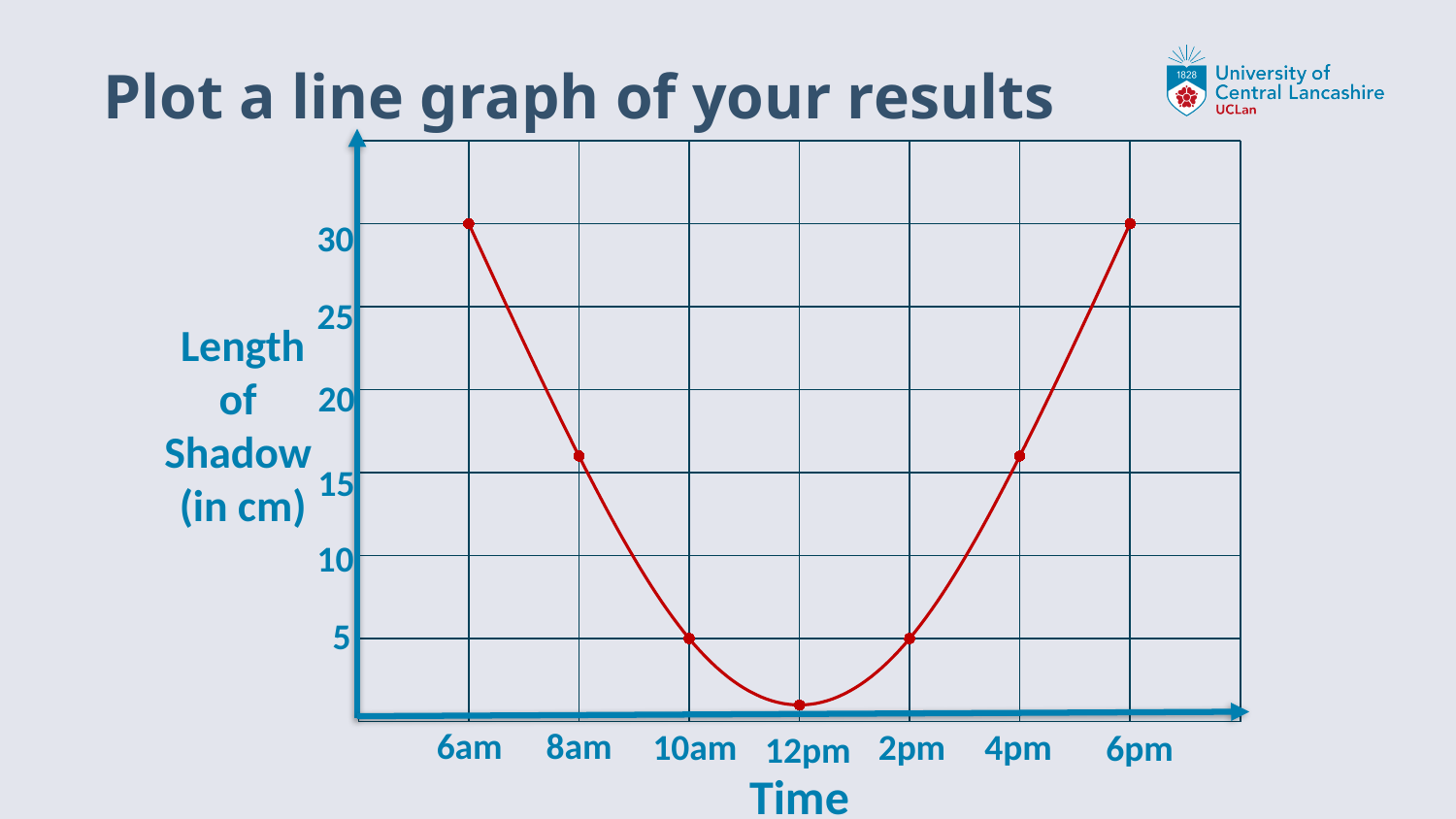
What is the length of the shadow at 2pm? 5 What is the length of the shadow at 6pm? 30 What is the difference between the shadow length at 6am and at 10am? 25 How many data points are plotted on the line graph? 7 Is the shadow length at 8am greater or less than 15? greater Does the shadow length rise or fall from 6am to 12pm? fall What kind of chart is shown on the slide? line chart At which time is the shadow length lowest? 12pm What is the label on the vertical axis of the graph? Length of Shadow (in cm) What is the length of the shadow at 6am? 30 Is the shadow length at 12pm greater or less than 5? less What is the length of the shadow at 10am? 5